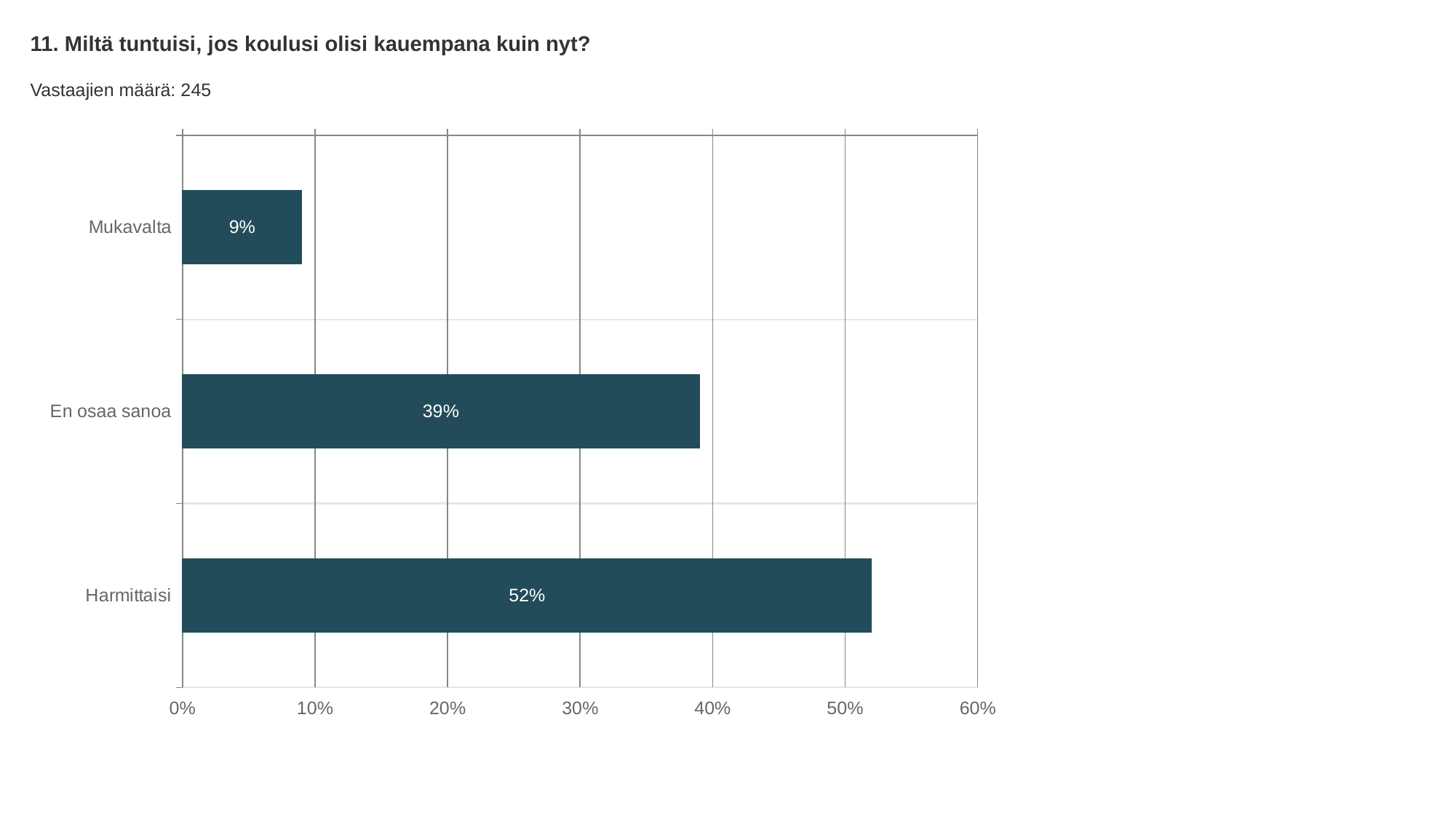
Which category has the lowest value? Mukavalta What is the value for Mukavalta? 9% Is the value for Harmittaisi greater or less than 50%? greater What is the value for Harmittaisi? 52% Which is larger, the value for En osaa sanoa or the value for Mukavalta? En osaa sanoa What kind of chart is shown on the slide? bar chart What is the difference between the values for Harmittaisi and En osaa sanoa? 13% What is the difference between the values for En osaa sanoa and Mukavalta? 30% How many respondents (Vastaajien määrä) does the slide report? 245 How many categories are shown in the chart? 3 Which category has the highest value? Harmittaisi What is the value for En osaa sanoa? 39%